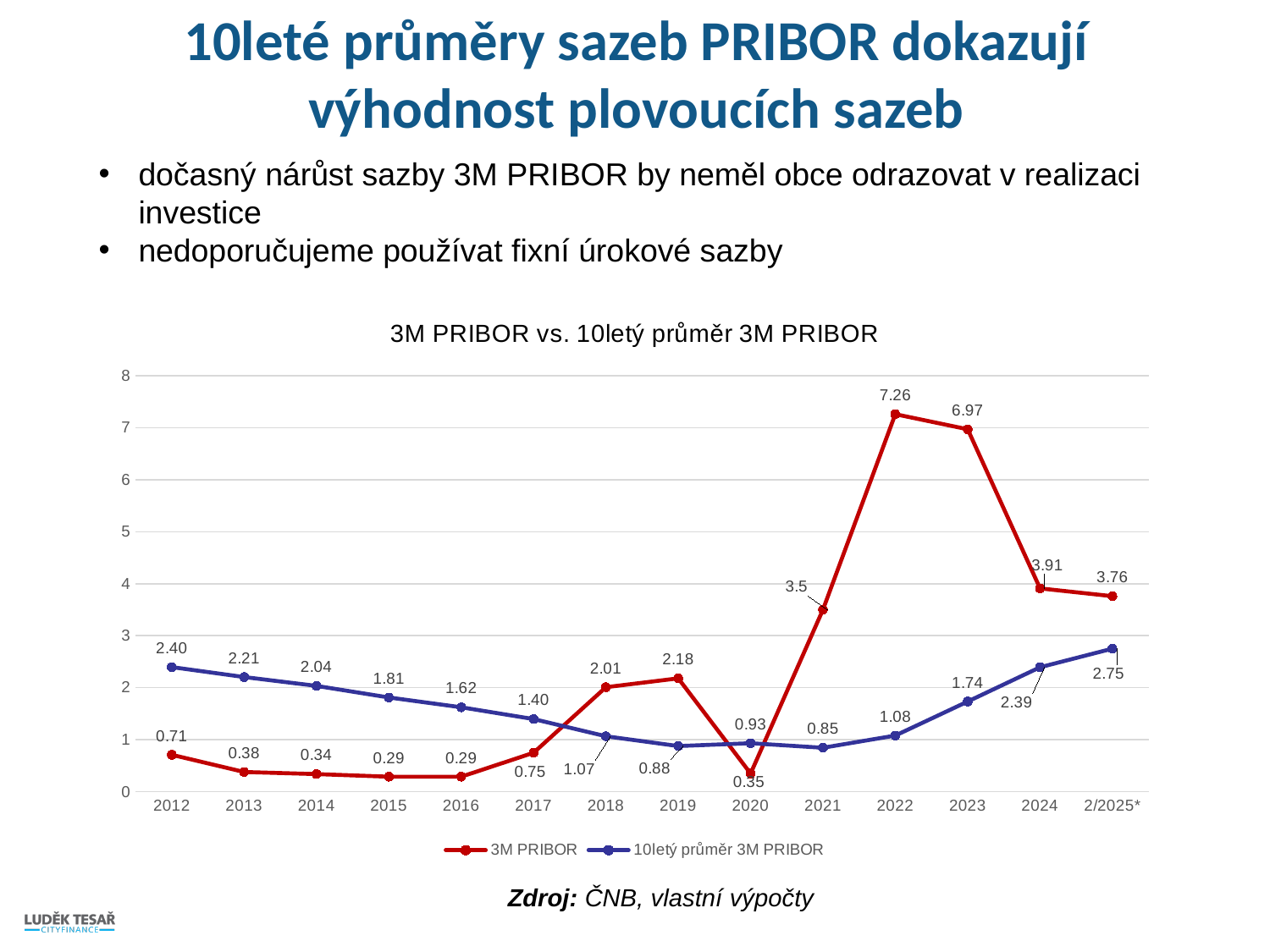
In which year does 3M PRIBOR reach its highest value? 2022 How many series does the chart legend list? 2 What is the difference between 3M PRIBOR and 10letý průměr 3M PRIBOR in 2022? 6.18 Is the value for 3M PRIBOR in 2023 greater or less than 6? greater What is the value of 3M PRIBOR in 2022? 7.26 How many time points are plotted along the x axis? 14 What is the value of 10letý průměr 3M PRIBOR in 2/2025*? 2.75 What is the title of the chart? 3M PRIBOR vs. 10letý průměr 3M PRIBOR Does the 10letý průměr 3M PRIBOR series rise or fall from 2012 to 2017? Fall What type of chart is shown on the slide? Line chart In 2018, which series has the higher value, 3M PRIBOR or 10letý průměr 3M PRIBOR? 3M PRIBOR In which year is 10letý průměr 3M PRIBOR at its lowest? 2021